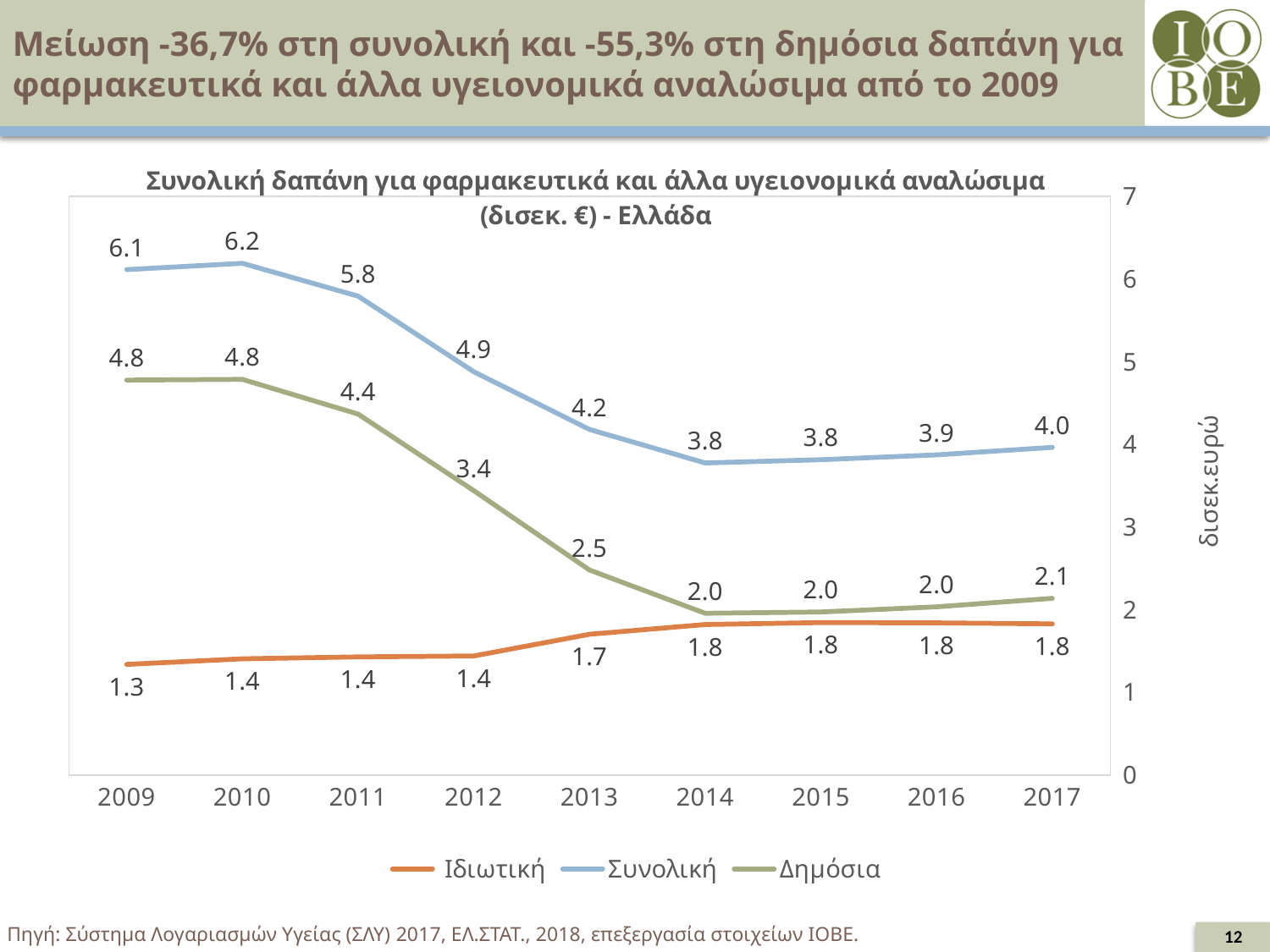
What is the value of Ιδιωτική in 2009? 1.3 In which year is Ιδιωτική lowest? 2009 In which year is Συνολική highest? 2010 Which is larger in 2014, Δημόσια or Ιδιωτική? Δημόσια What is the difference between Δημόσια in 2009 and Δημόσια in 2017? 2.7 Does Δημόσια rise or fall from 2009 to 2014? fall What is the value of Δημόσια in 2013? 2.5 What is the title of the chart? Συνολική δαπάνη για φαρμακευτικά και άλλα υγειονομικά αναλώσιμα (δισεκ. €) - Ελλάδα What type of chart is shown on the slide? line chart What is the value of Συνολική in 2010? 6.2 How many series does the legend list? 3 How many years are shown on the x axis? 9